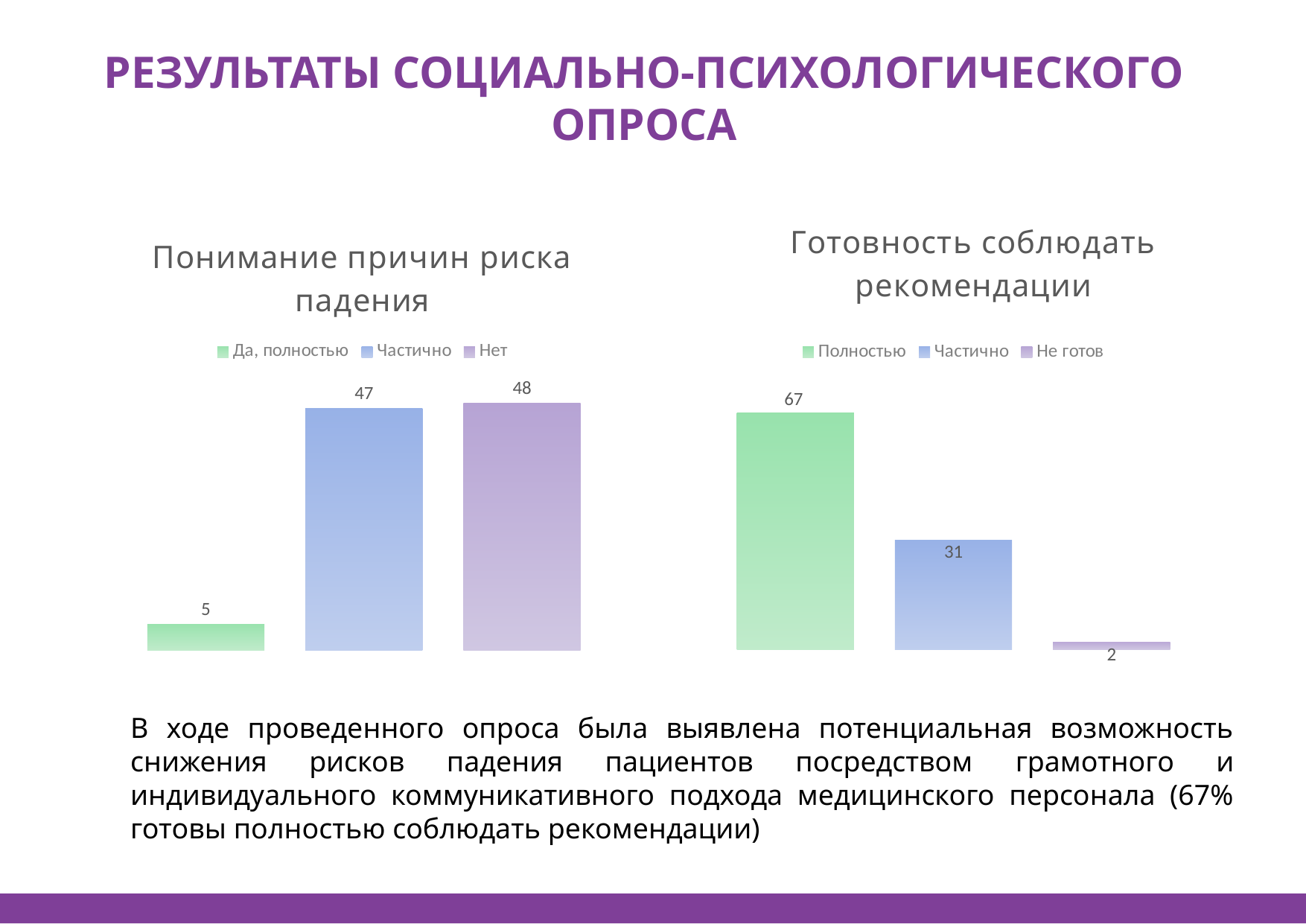
In the chart titled 'Понимание причин риска падения', which category has the lowest value? Да, полностью In the chart titled 'Понимание причин риска падения', what is the value for 'Нет'? 48 In the chart titled 'Готовность соблюдать рекомендации', which is larger: 'Частично' or 'Не готов'? Частично In the chart titled 'Понимание причин риска падения', what is the value for 'Да, полностью'? 5 In the chart titled 'Понимание причин риска падения', what is the difference between the values for 'Нет' and 'Да, полностью'? 43 In the chart titled 'Готовность соблюдать рекомендации', what is the value for 'Полностью'? 67 In the chart titled 'Готовность соблюдать рекомендации', what is the difference between the values for 'Полностью' and 'Частично'? 36 How many series does the legend of the chart titled 'Готовность соблюдать рекомендации' list? 3 In the chart titled 'Готовность соблюдать рекомендации', which category has the highest value? Полностью What kind of chart is the chart titled 'Понимание причин риска падения'? Bar chart In the chart titled 'Понимание причин риска падения', what is the value for 'Частично'? 47 In the chart titled 'Готовность соблюдать рекомендации', what is the value for 'Не готов'? 2